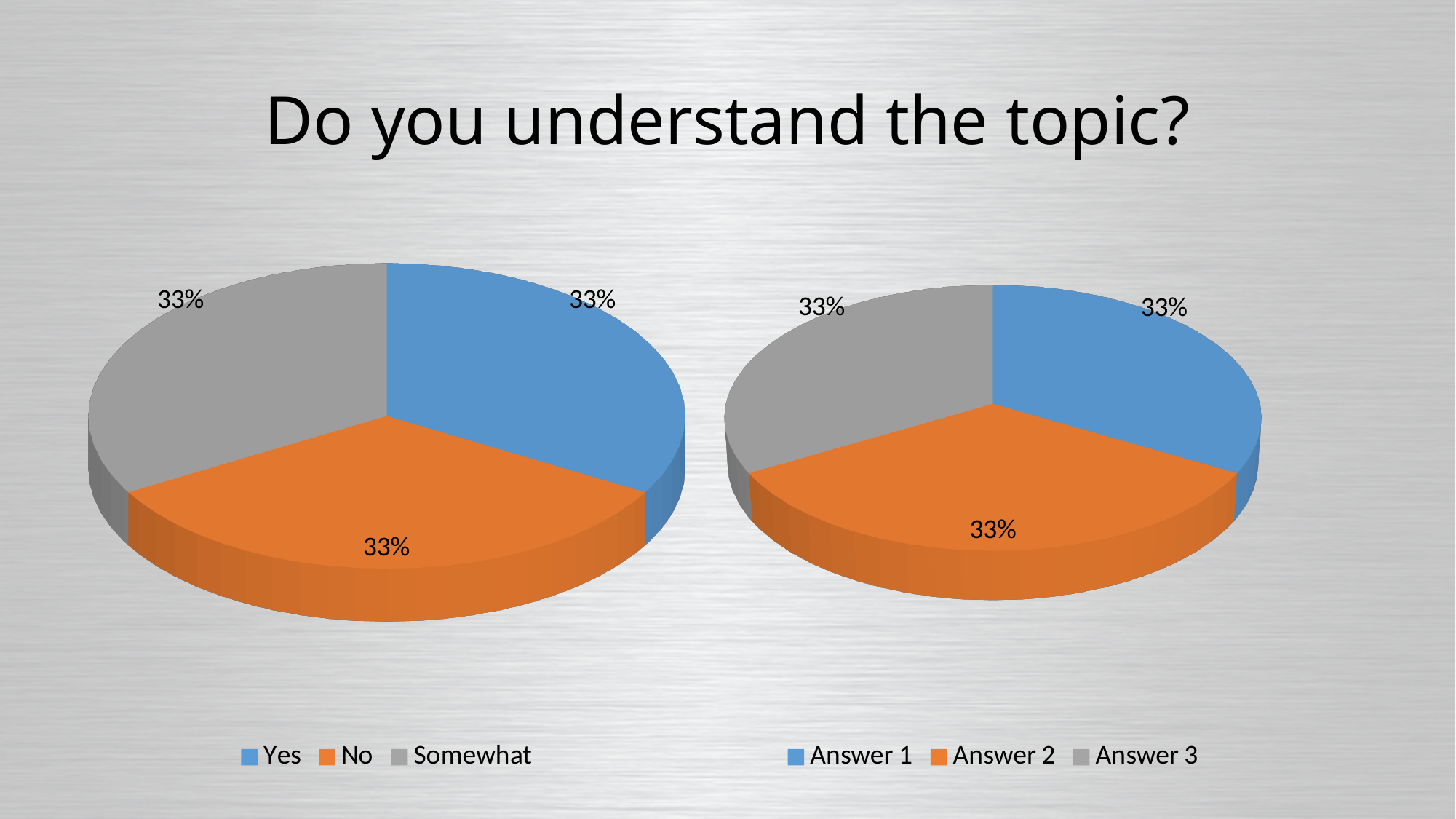
What kind of chart is the chart on the left of the slide? Pie chart In the left pie chart, which category is shown in orange? No In the left pie chart, what share is labelled for the Yes slice? 33% In the left pie chart, what percentage is shown for the No slice? 33% How many slices does the left pie chart have? 3 How many entries does the legend of the right pie chart list? 3 In the left pie chart, what percentage is shown for the Somewhat slice? 33% What kind of chart is the chart on the right of the slide? Pie chart In the right pie chart, what share of the pie does Answer 1 take? 33% In the right pie chart, what percentage is shown for Answer 2? 33% In the right pie chart, which category is shown in grey? Answer 3